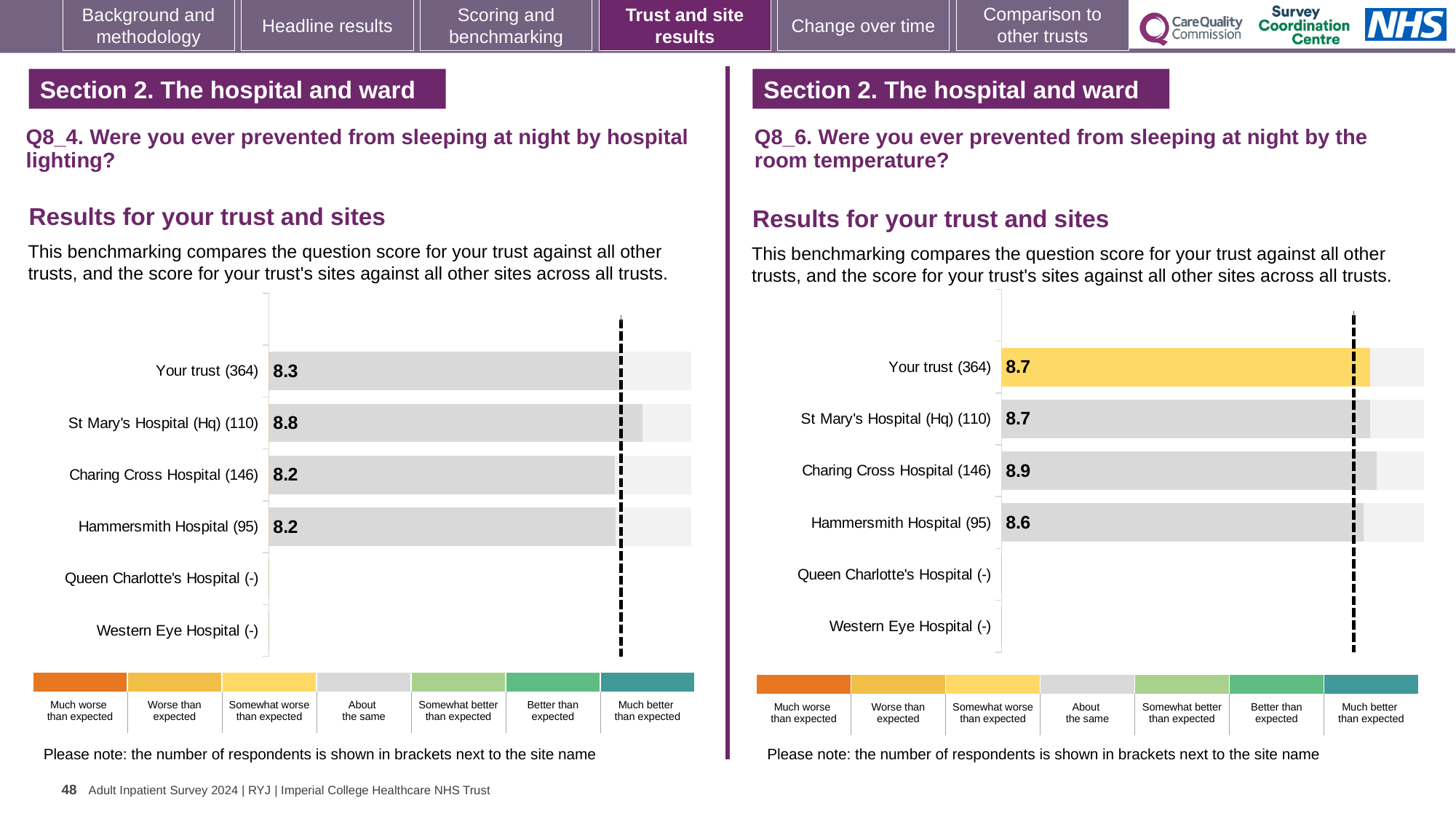
On the Q8_6 room temperature chart, what is the score for Charing Cross Hospital (146)? 8.9 On the Q8_6 room temperature chart, which benchmark category does the yellow colour of the Your trust bar correspond to in the legend? Somewhat worse than expected On the Q8_6 room temperature chart, which site has the highest score? Charing Cross Hospital (146) On the Q8_6 room temperature chart, which is larger: the score for Charing Cross Hospital or the score for Hammersmith Hospital? Charing Cross Hospital On the Q8_4 hospital lighting chart, what is the score for Your trust (364)? 8.3 On the Q8_4 hospital lighting chart, what is the difference between the scores for St Mary's Hospital (Hq) and Charing Cross Hospital? 0.6 On the Q8_4 hospital lighting chart, how many sites or categories are listed on the vertical axis? 6 On the Q8_6 room temperature chart, which of the scored sites has the lowest score? Hammersmith Hospital (95) On the Q8_6 room temperature chart, what is the score for Hammersmith Hospital (95)? 8.6 On the Q8_4 hospital lighting chart, which site has the highest score? St Mary's Hospital (Hq) (110) On the Q8_4 hospital lighting chart, what is the score for St Mary's Hospital (Hq) (110)? 8.8 What kind of chart is used on the Q8_4 hospital lighting side of the slide? Bar chart